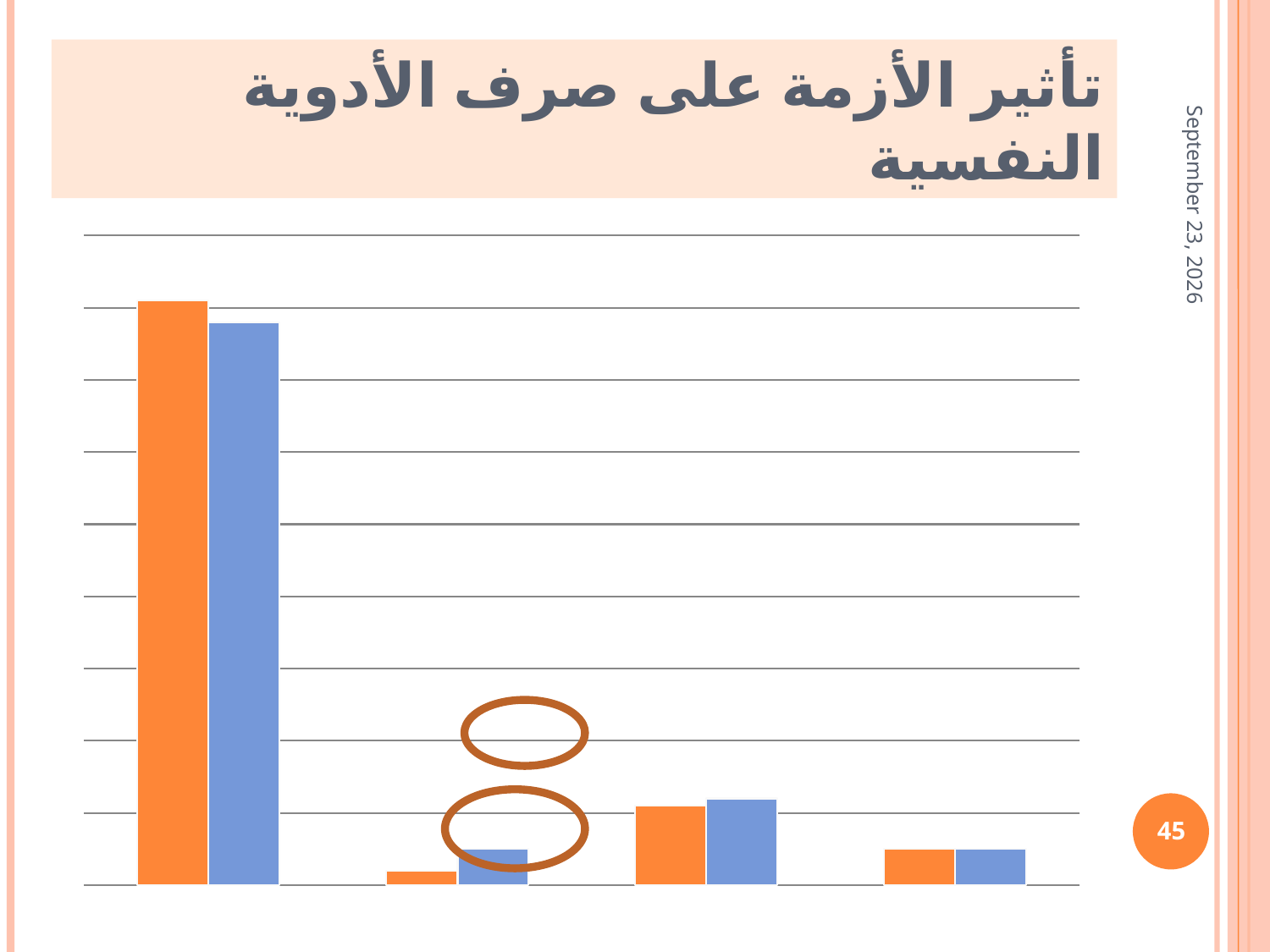
How many bar colours (series) are plotted in each category group? 2 In the third category group from the left, which bar is taller, the orange one or the blue one? the blue one Is the orange bar in the leftmost group taller than the orange bar in the third group? yes Which category group has the tallest bars in the chart? the leftmost (first) group What is the title of the slide containing the chart? تأثير الأزمة على صرف الأدوية النفسية In the second category group from the left, which bar is taller, the orange one or the blue one? the blue one How many groups of bars (categories) are plotted in the chart? 4 Which category group has the shortest bars in the chart? the second group from the left What two colours are used for the bars in the chart? orange and blue What kind of chart is shown on the slide? bar chart